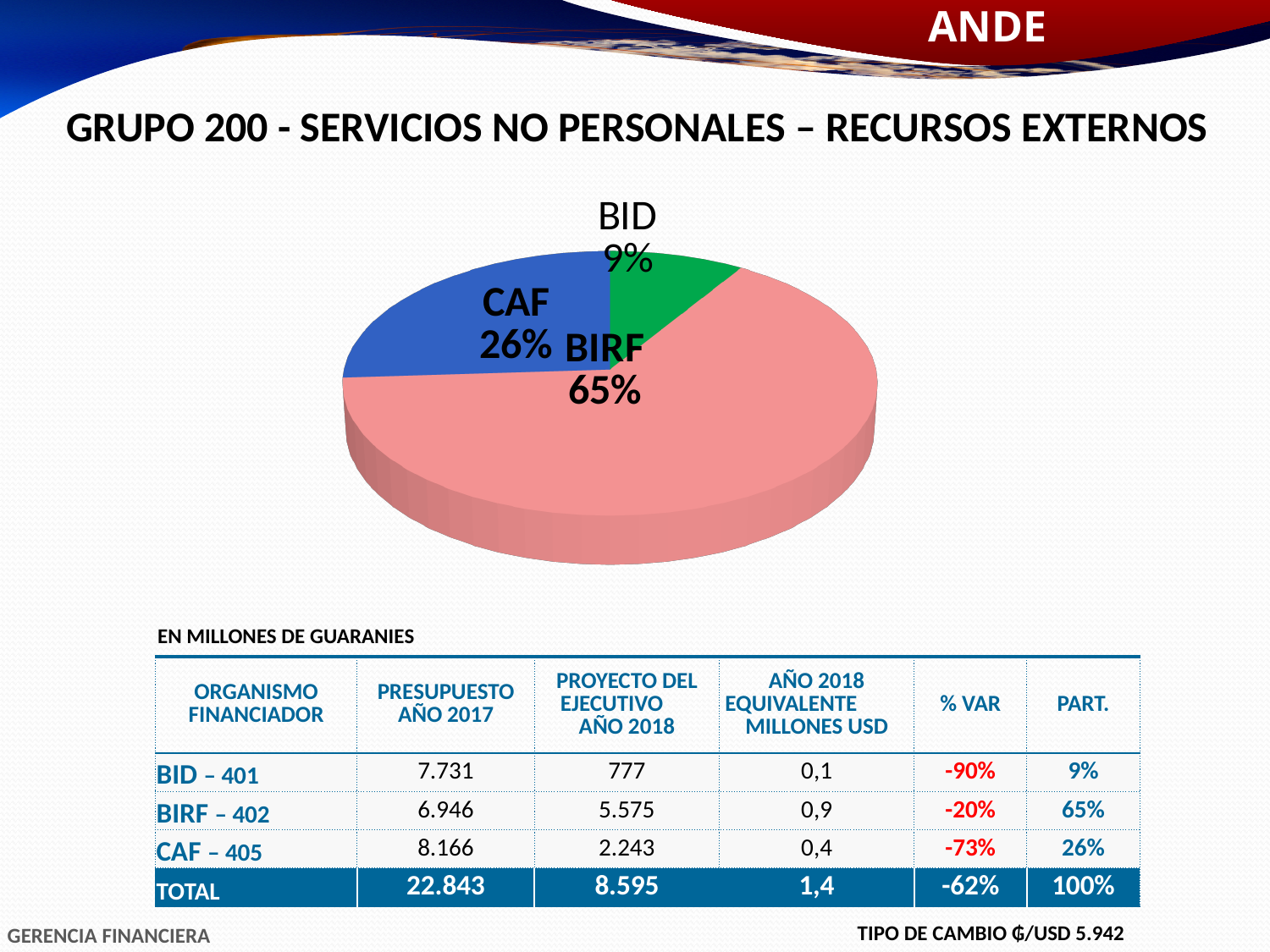
What share of the pie does CAF represent? 26% Which slice of the pie chart is the smallest? BID What kind of chart is shown on the slide? pie chart How many slices does the pie chart have? 3 What share of the pie does BID represent? 9% What colour is the CAF slice of the pie chart? blue What is the difference in percentage points between the CAF and BID slices? 17 What colour is the BIRF slice of the pie chart? pink What share of the pie does BIRF represent? 65% Which slice of the pie chart is the largest? BIRF Which slice is larger, CAF or BID? CAF What is the difference in percentage points between the BIRF and CAF slices? 39